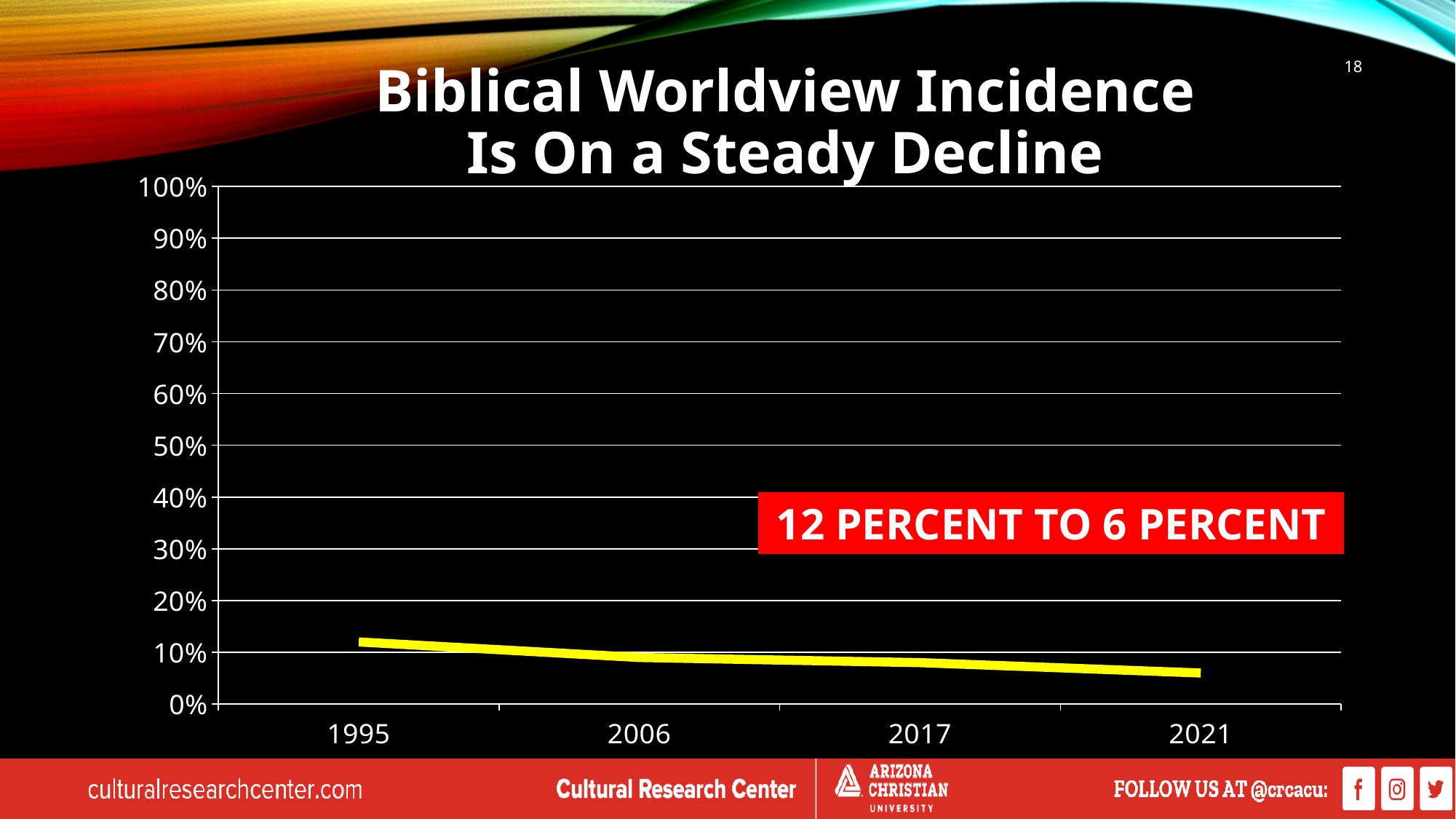
What is the title of the chart? Biblical Worldview Incidence Is On a Steady Decline Is the value for 1995 greater or less than 10%? greater Do the values rise or fall from 1995 to 2021? fall Which is larger, the value for 1995 or the value for 2021? 1995 How many years are plotted along the x axis? 4 Is the value for 2021 greater or less than 10%? less According to the red annotation on the chart, the incidence declined from what to what? 12 percent to 6 percent What kind of chart is shown on the slide? line chart Is the value for 1995 greater or less than 20%? less Which year has the highest value? 1995 Which year has the lowest value? 2021